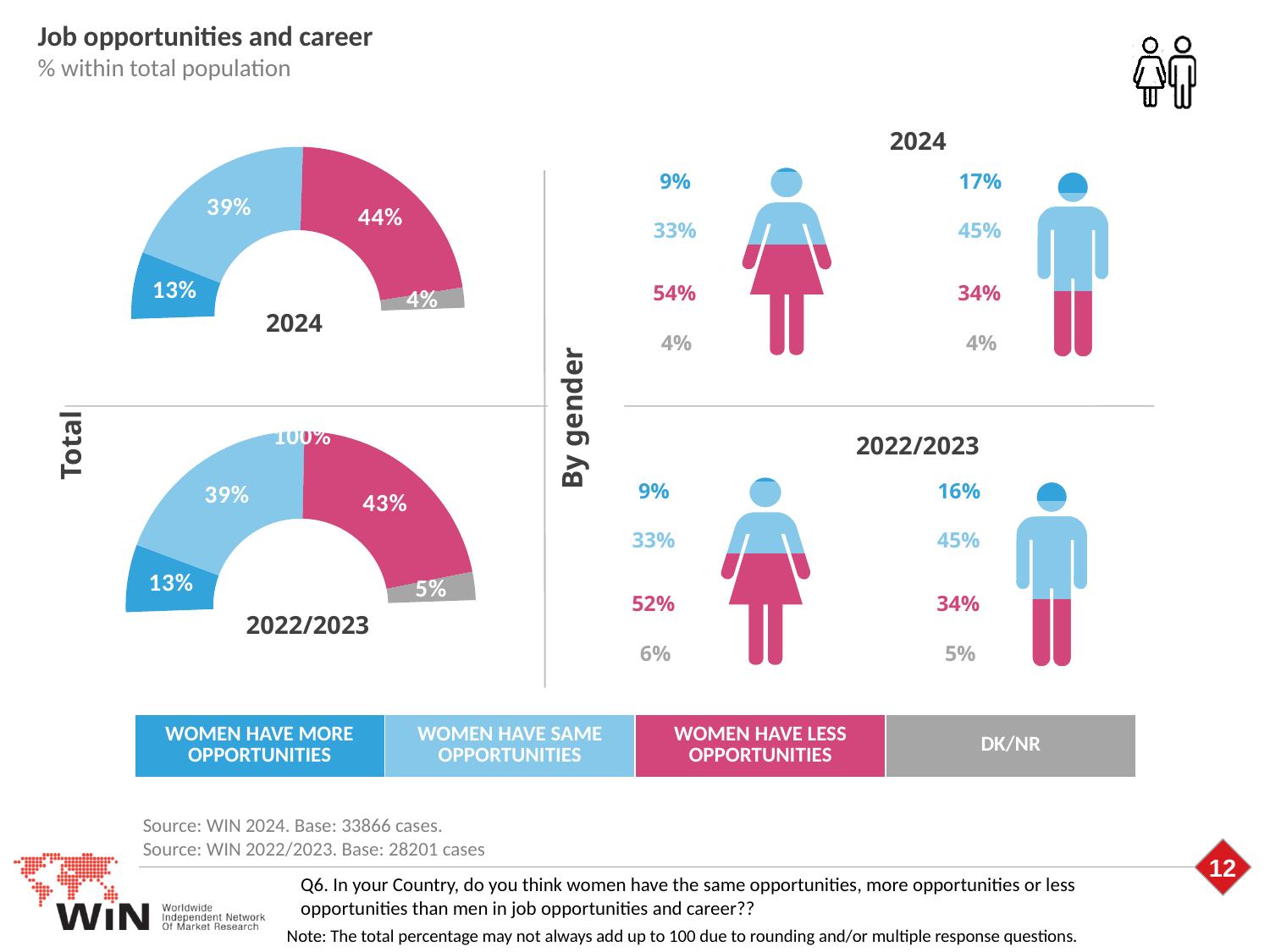
In the By gender 2022/2023 section, what percentage of men say women have more opportunities? 16% In the By gender 2024 section, which is larger: the share of women or the share of men saying women have less opportunities? Women In the By gender 2024 section, what is the difference between the share of men and the share of women saying women have more opportunities? 8% In the Total 2024 chart, what is the difference between the share saying women have less opportunities and the share saying women have the same opportunities? 5% In the By gender 2024 section, what percentage of men say women have the same opportunities? 45% In the Total 2024 chart, what percentage say women have less opportunities? 44% In the Total 2022/2023 chart, which response category has the smallest share? DK/NR How many response categories does the legend at the bottom of the slide list? 4 In the Total 2022/2023 chart, what percentage say women have more opportunities? 13% In the Total 2024 chart, which response category has the largest share? Women have less opportunities In the By gender 2022/2023 section, what is the DK/NR percentage for women? 6% In the By gender 2024 section, what percentage of women say women have less opportunities? 54%